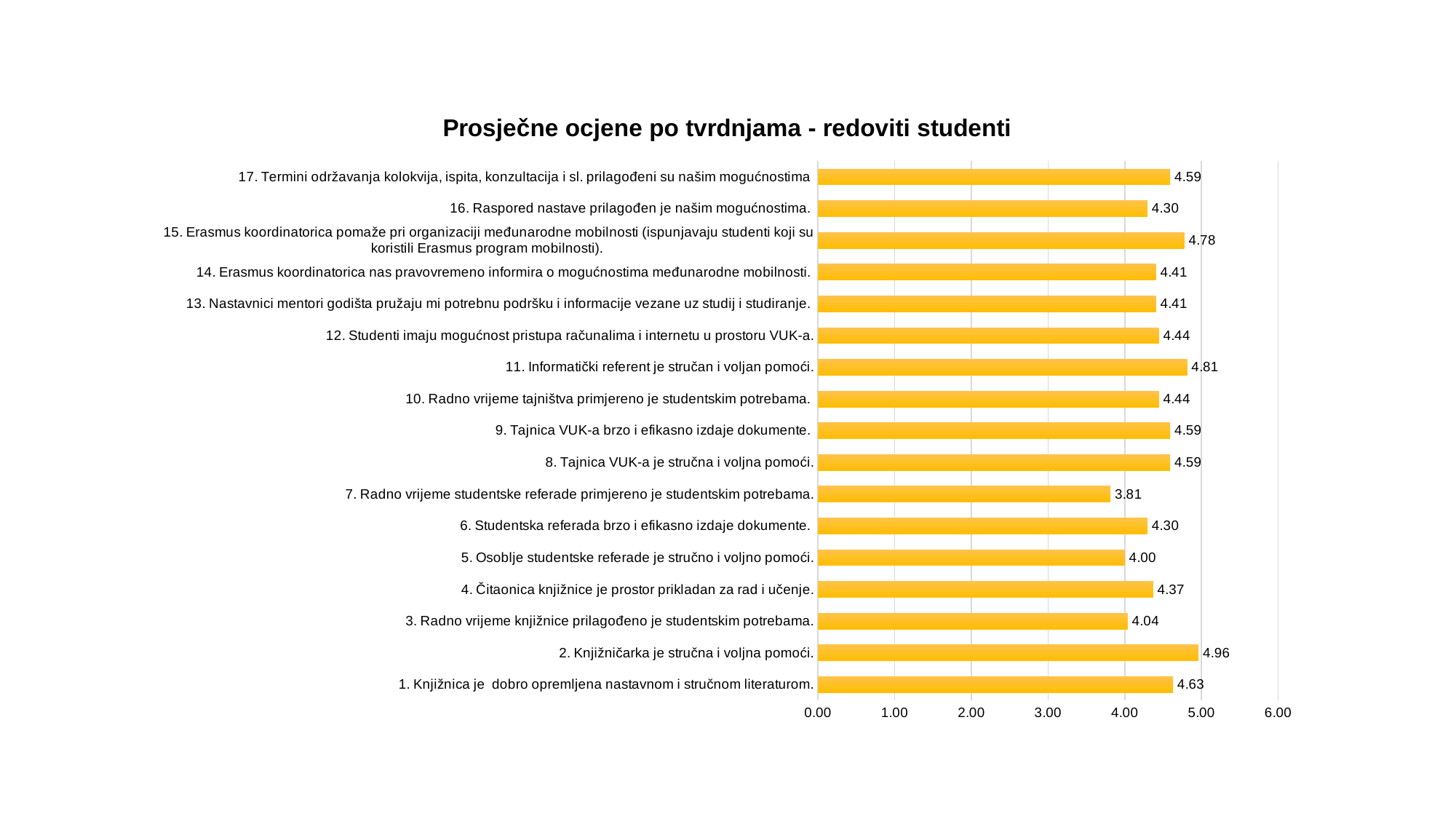
Is the average score for statement 5, "Osoblje studentske referade je stručno i voljno pomoći.", greater or less than 4.00? Neither, it is exactly 4.00 What is the maximum value shown on the horizontal axis? 6.00 What is the difference between the average scores of statement 2 (4.96) and statement 7 (3.81)? 1.15 What is the average score for statement 7, "Radno vrijeme studentske referade primjereno je studentskim potrebama."? 3.81 What is the average score for statement 15 about the Erasmus coordinator helping organise international mobility? 4.78 Which statement has the lowest average score? 7. Radno vrijeme studentske referade primjereno je studentskim potrebama. What is the title of the chart? Prosječne ocjene po tvrdnjama - redoviti studenti What type of chart is shown on the slide? Bar chart Which statement has the highest average score? 2. Knjižničarka je stručna i voljna pomoći. How many statements (bars) are shown in the chart? 17 Which has a higher average score: statement 11 (Informatički referent) or statement 12 (pristup računalima i internetu)? Statement 11 What is the average score for statement 2, "Knjižničarka je stručna i voljna pomoći."? 4.96